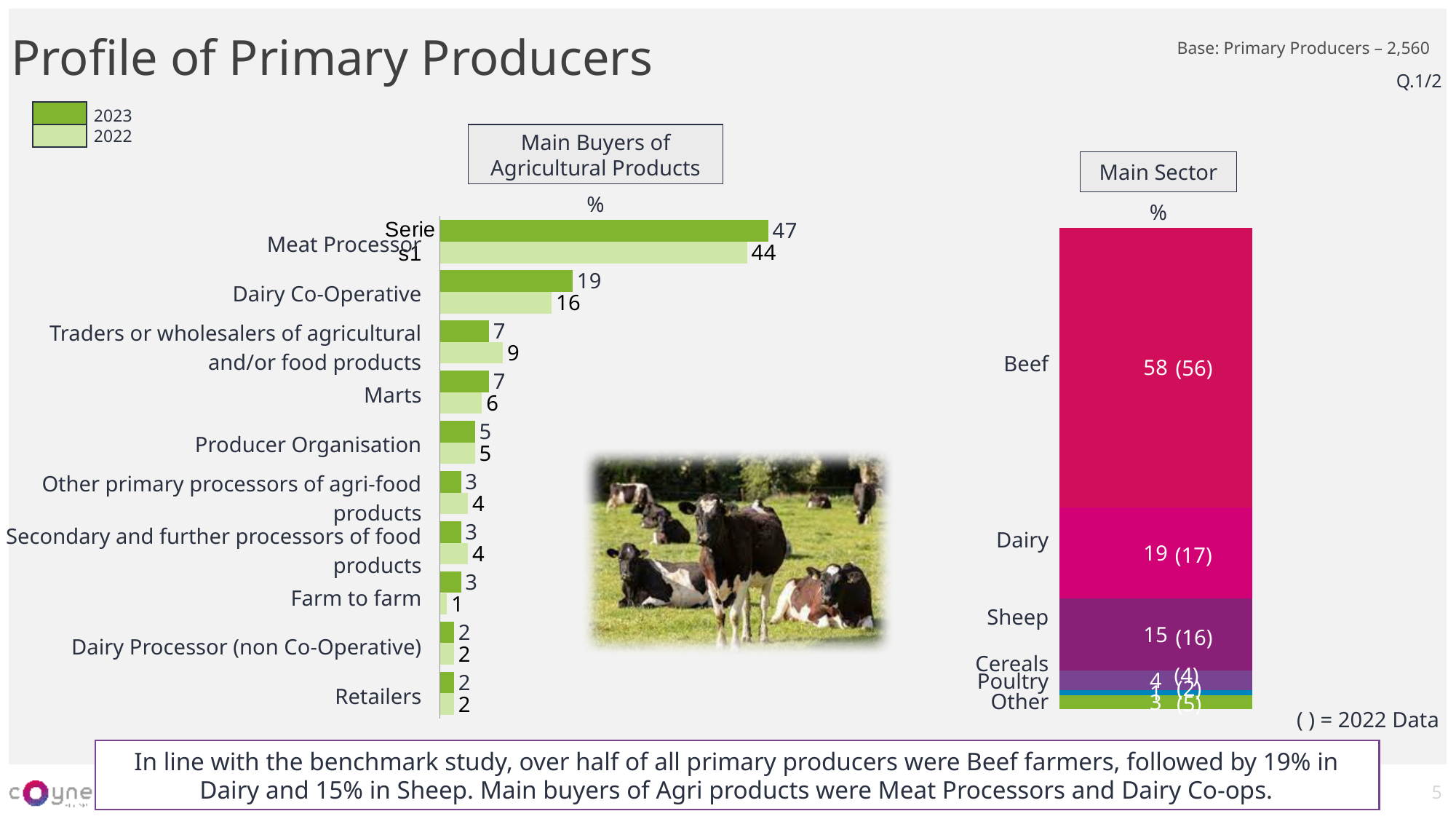
In the Main Buyers of Agricultural Products chart, what is the 2023 value for Meat Processor? 47 In the Main Sector chart, what is the 2023 value for Beef? 58 In the Main Sector chart, which sector has the largest 2023 share? Beef How many categories are shown in the Main Buyers of Agricultural Products chart? 10 In the Main Sector chart, what is the difference between the 2023 values for Dairy and Sheep? 4 In the Main Buyers of Agricultural Products chart, which is larger for Traders or wholesalers of agricultural and/or food products: the 2023 value or the 2022 value? 2022 In the Main Sector chart, what is the 2022 value for Sheep shown in parentheses? 16 What kind of chart is the Main Buyers of Agricultural Products chart? Bar chart In the Main Buyers of Agricultural Products chart, which category has the highest 2023 value? Meat Processor How many series does the legend list for the Main Buyers of Agricultural Products chart? 2 In the Main Buyers of Agricultural Products chart, what is the 2022 value for Dairy Co-Operative? 16 In the Main Buyers of Agricultural Products chart, what is the difference between the 2023 and 2022 values for Meat Processor? 3